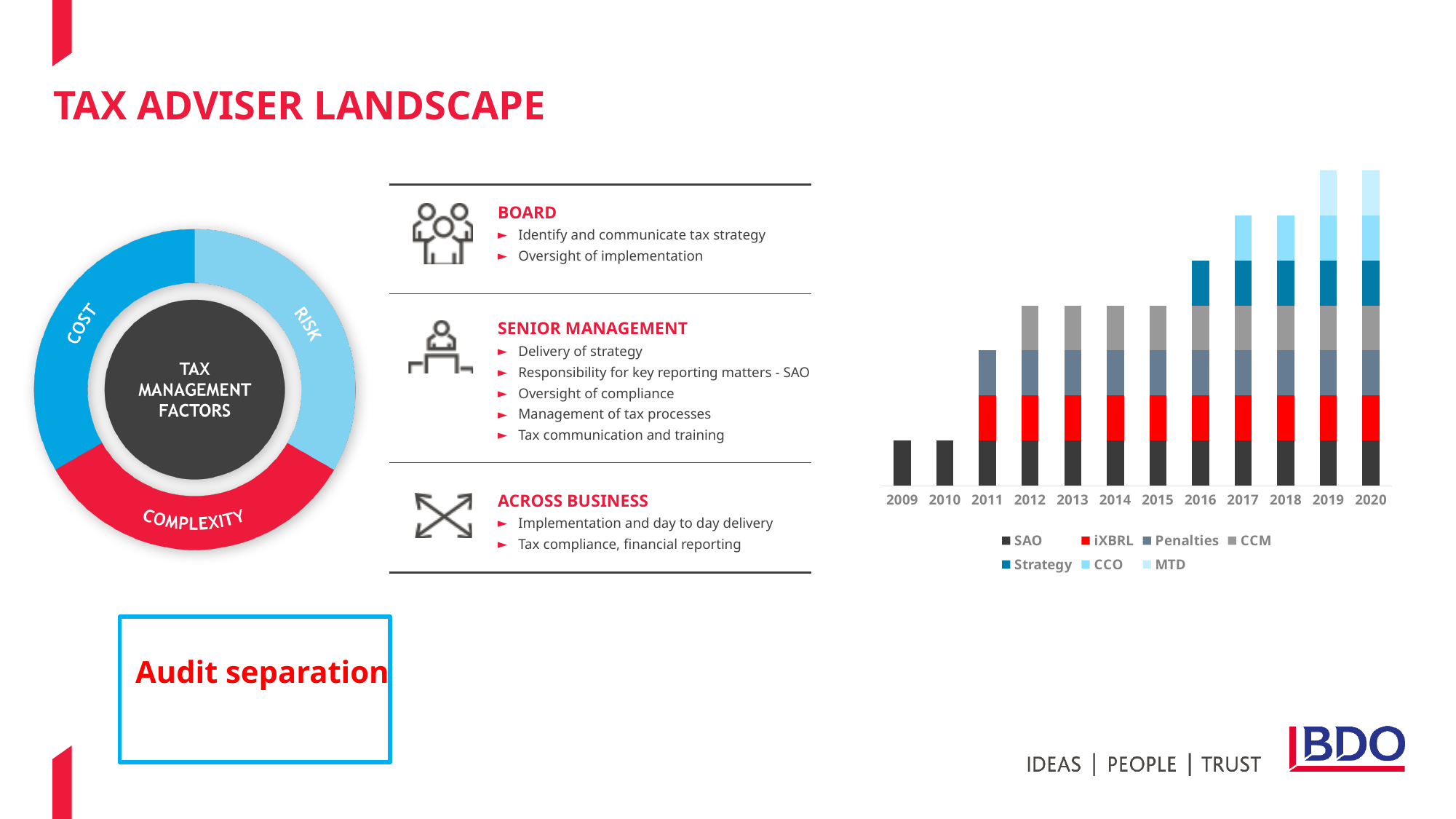
What is the first year shown on the x axis of the stacked bar chart? 2009 How many years are shown on the x axis of the stacked bar chart? 12 In the stacked bar chart, which bar is taller, 2011 or 2016? 2016 What kind of chart is shown on the right of the slide? Stacked bar chart How many series does the legend of the stacked bar chart list? 7 Do the stacked bar totals generally rise or fall from 2009 to 2020? Rise In the stacked bar chart, which bar is taller, 2015 or 2017? 2017 In which year does the MTD segment first appear in the stacked bar chart? 2019 In the stacked bar chart, which bar is taller, 2009 or 2012? 2012 In which year does the Strategy segment first appear in the stacked bar chart? 2016 Which series appears at the bottom of every bar in the stacked bar chart? SAO Which series is shown in red in the stacked bar chart legend? iXBRL